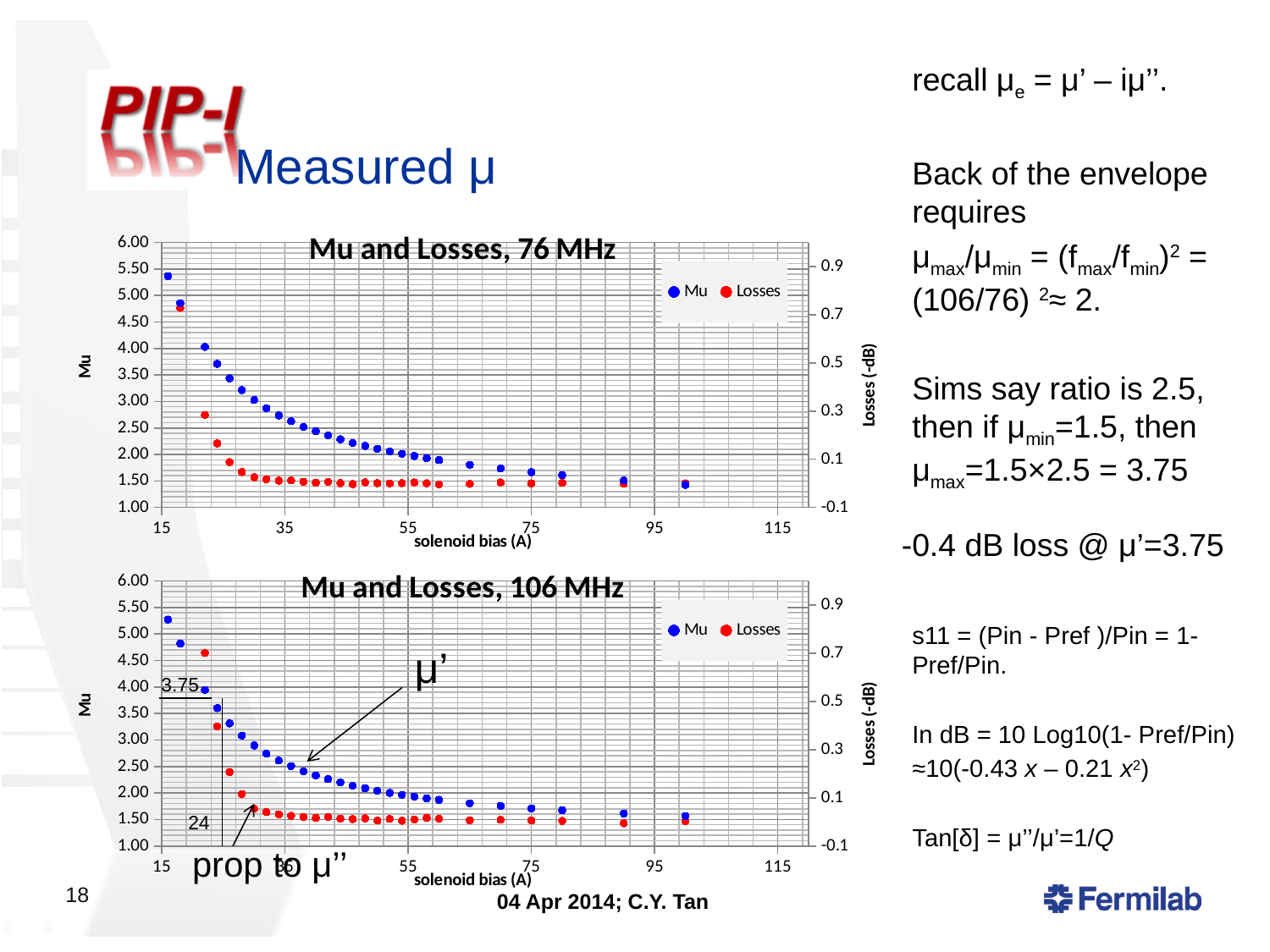
In the 'Mu and Losses, 76 MHz' chart, what are the two series named in the legend? Mu and Losses In the 'Mu and Losses, 76 MHz' chart, is the Mu value at the highest solenoid bias (about 100 A) greater or less than 2.00? less How many series does the legend of the 'Mu and Losses, 106 MHz' chart list? 2 In the 'Mu and Losses, 106 MHz' chart, is the Losses value at the highest solenoid bias (about 100 A) greater or less than 0.1? less In the 'Mu and Losses, 76 MHz' chart, is the Mu value at the lowest solenoid bias (about 15 A) greater or less than 5.00? greater In the 'Mu and Losses, 76 MHz' chart, which is larger: the Mu value at about 15 A or the Mu value at about 35 A? the Mu value at about 15 A What is the x-axis title of the 'Mu and Losses, 106 MHz' chart? solenoid bias (A) In the 'Mu and Losses, 106 MHz' chart, does the Losses series rise or fall as solenoid bias increases? fall What kind of chart is the 'Mu and Losses, 76 MHz' chart? scatter chart In the 'Mu and Losses, 76 MHz' chart, does the Mu series rise or fall as solenoid bias increases? fall